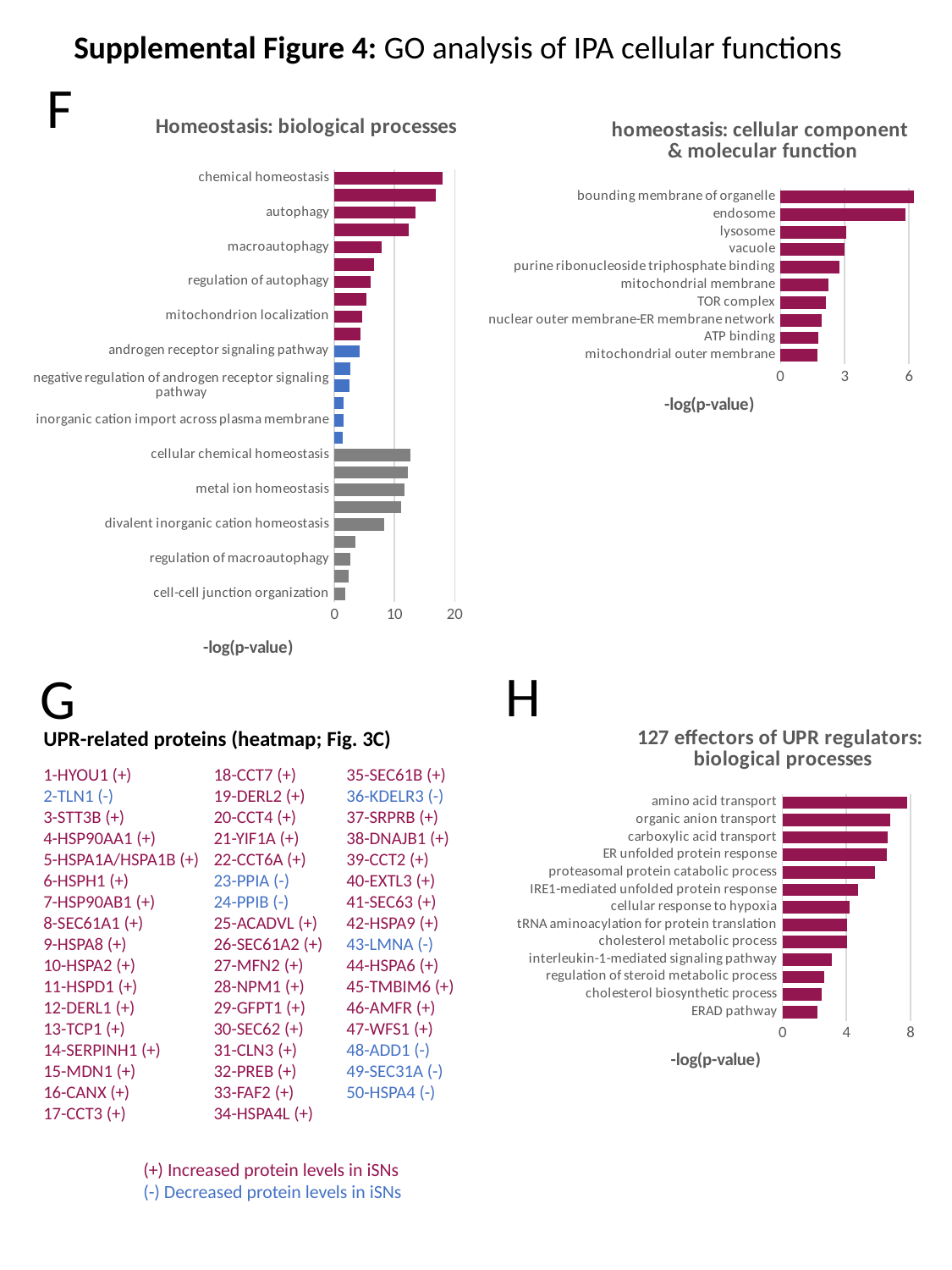
In the '127 effectors of UPR regulators: biological processes' chart, is the value for ERAD pathway greater or less than 4? less How many categories are shown in the 'homeostasis: cellular component & molecular function' chart? 10 In the '127 effectors of UPR regulators: biological processes' chart, which category has the highest -log(p-value)? amino acid transport How many categories are shown in the '127 effectors of UPR regulators: biological processes' chart? 13 In the 'homeostasis: cellular component & molecular function' chart, which category has the highest -log(p-value)? bounding membrane of organelle What kind of chart is the 'homeostasis: cellular component & molecular function' chart? bar chart In the 'Homeostasis: biological processes' chart, is the value for cell-cell junction organization greater or less than 10? less In the 'Homeostasis: biological processes' chart, which category has the highest -log(p-value)? chemical homeostasis In the 'Homeostasis: biological processes' chart, which is larger, the value for cellular chemical homeostasis or the value for regulation of macroautophagy? cellular chemical homeostasis In the 'homeostasis: cellular component & molecular function' chart, which is larger, the value for endosome or the value for lysosome? endosome In the 'Homeostasis: biological processes' chart, is the value for chemical homeostasis greater or less than 10? greater